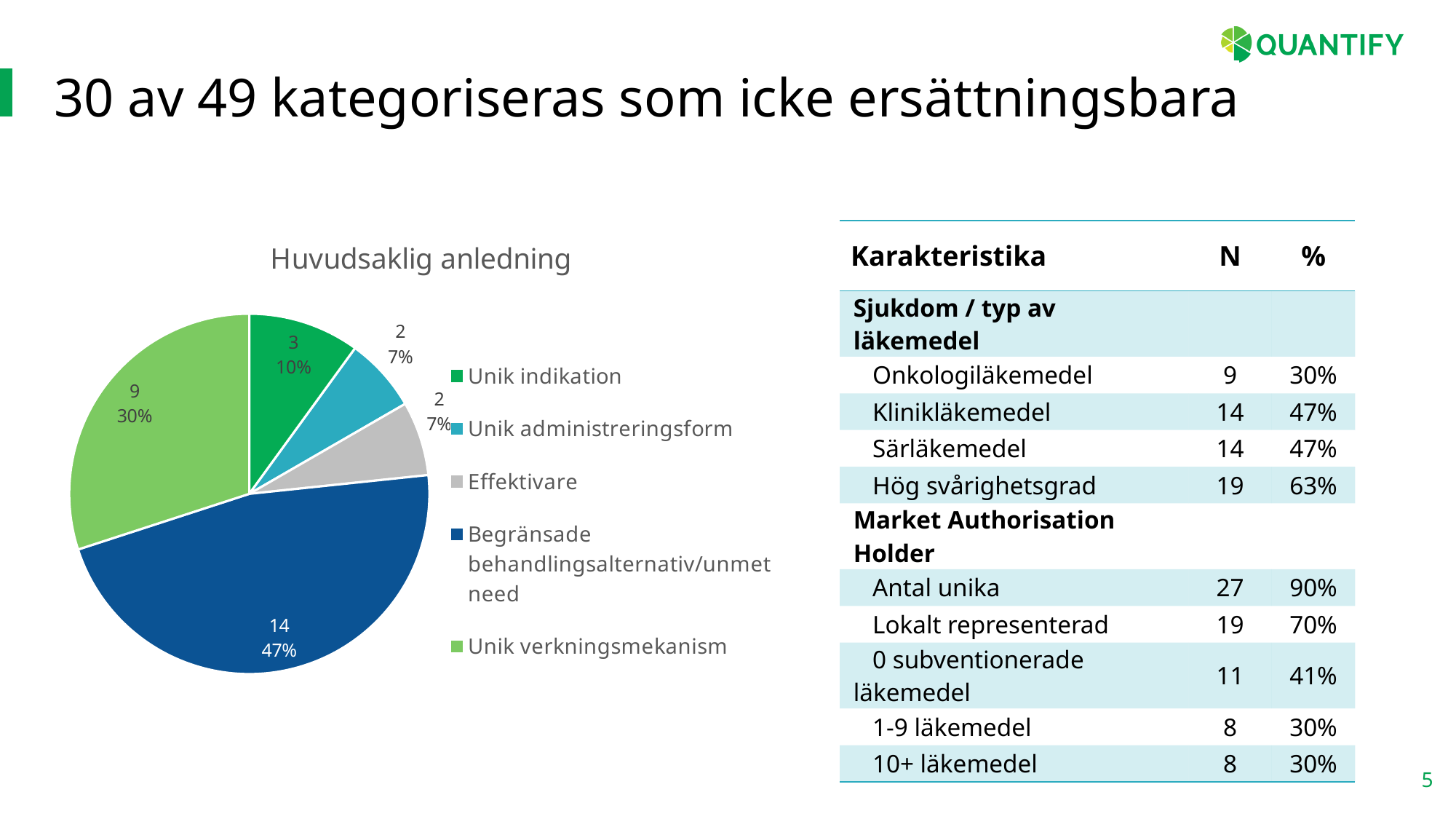
What is the title of the chart? Huvudsaklig anledning Which category has the largest slice? Begränsade behandlingsalternativ/unmet need What percentage share does Unik administreringsform have? 7% How many slices does the pie chart have? 5 What percentage share does Unik indikation have? 10% What is the count shown for Unik indikation? 3 Which is larger, the count for Unik indikation or the count for Effektivare? Unik indikation What is the count shown for Begränsade behandlingsalternativ/unmet need? 14 What is the difference in count between Begränsade behandlingsalternativ/unmet need and Unik verkningsmekanism? 5 What percentage share does Unik verkningsmekanism have? 30% Which colour represents Effektivare in the legend? grey What type of chart is shown on the slide? pie chart